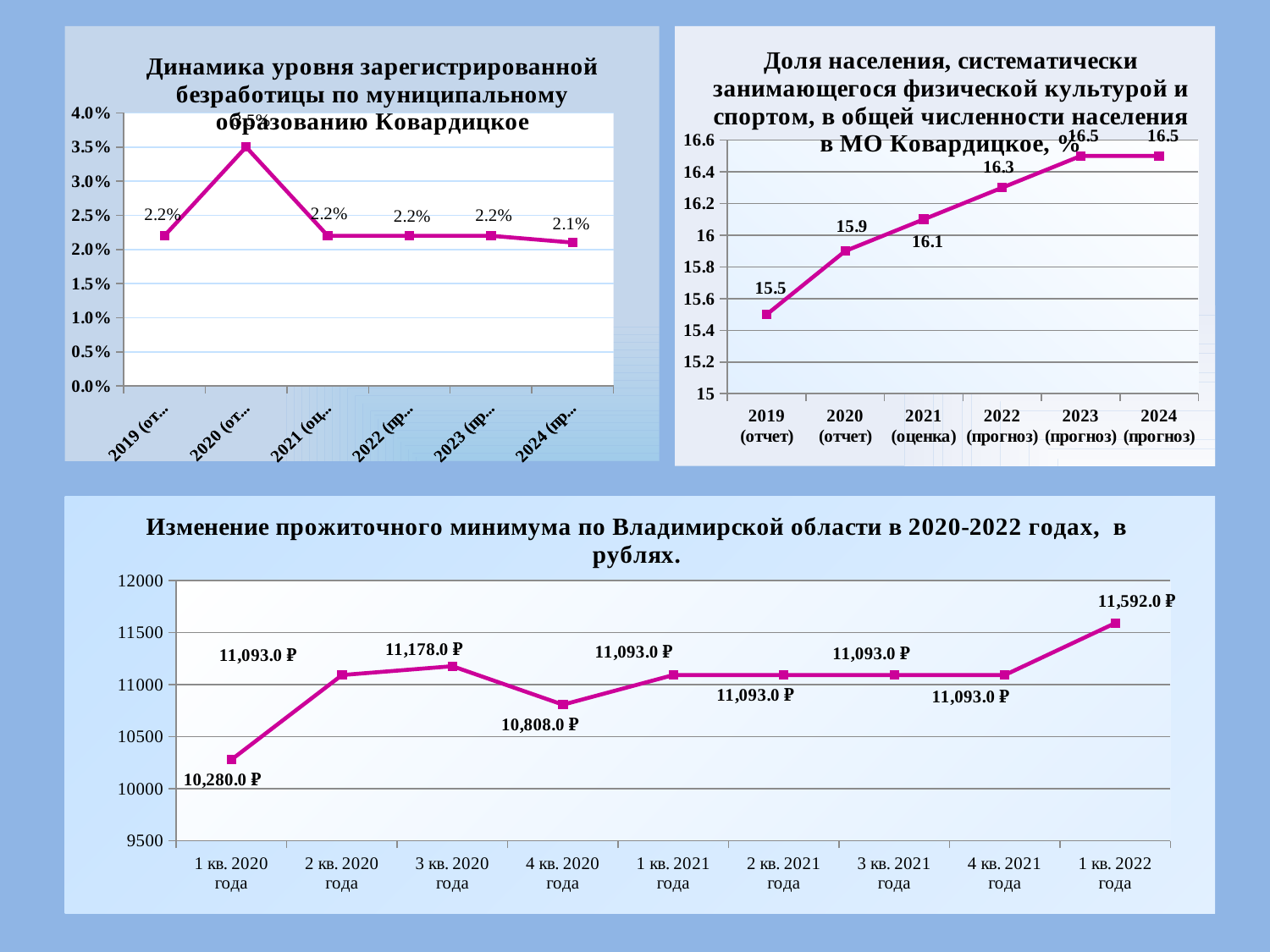
In the bottom chart (Изменение прожиточного минимума по Владимирской области), what is the value for 1 кв. 2020 года? 10,280.0 ₽ In the top-right chart (Доля населения, систематически занимающегося физической культурой и спортом), what is the difference between the values for 2023 (прогноз) and 2019 (отчет)? 1.0 In the bottom chart (Изменение прожиточного минимума по Владимирской области), what is the difference between the values for 1 кв. 2022 года and 4 кв. 2021 года? 499.0 ₽ In the top-left chart (Динамика уровня зарегистрированной безработицы), which year has the highest value? 2020 In the top-right chart (Доля населения, систематически занимающегося физической культурой и спортом), what is the value for 2021 (оценка)? 16.1 In the top-right chart (Доля населения, систематически занимающегося физической культурой и спортом), do the values generally rise or fall from 2019 to 2024? rise In the bottom chart (Изменение прожиточного минимума по Владимирской области), which quarter has the highest value? 1 кв. 2022 года What kind of chart is the top-left chart (Динамика уровня зарегистрированной безработицы)? line chart In the bottom chart (Изменение прожиточного минимума по Владимирской области), which quarter has the lowest value? 1 кв. 2020 года In the top-right chart (Доля населения, систематически занимающегося физической культурой и спортом), which is larger, the value for 2020 (отчет) or 2022 (прогноз)? 2022 (прогноз) In the bottom chart (Изменение прожиточного минимума по Владимирской области), how many quarters are plotted? 9 In the top-left chart (Динамика уровня зарегистрированной безработицы), what is the value for 2024? 2.1%